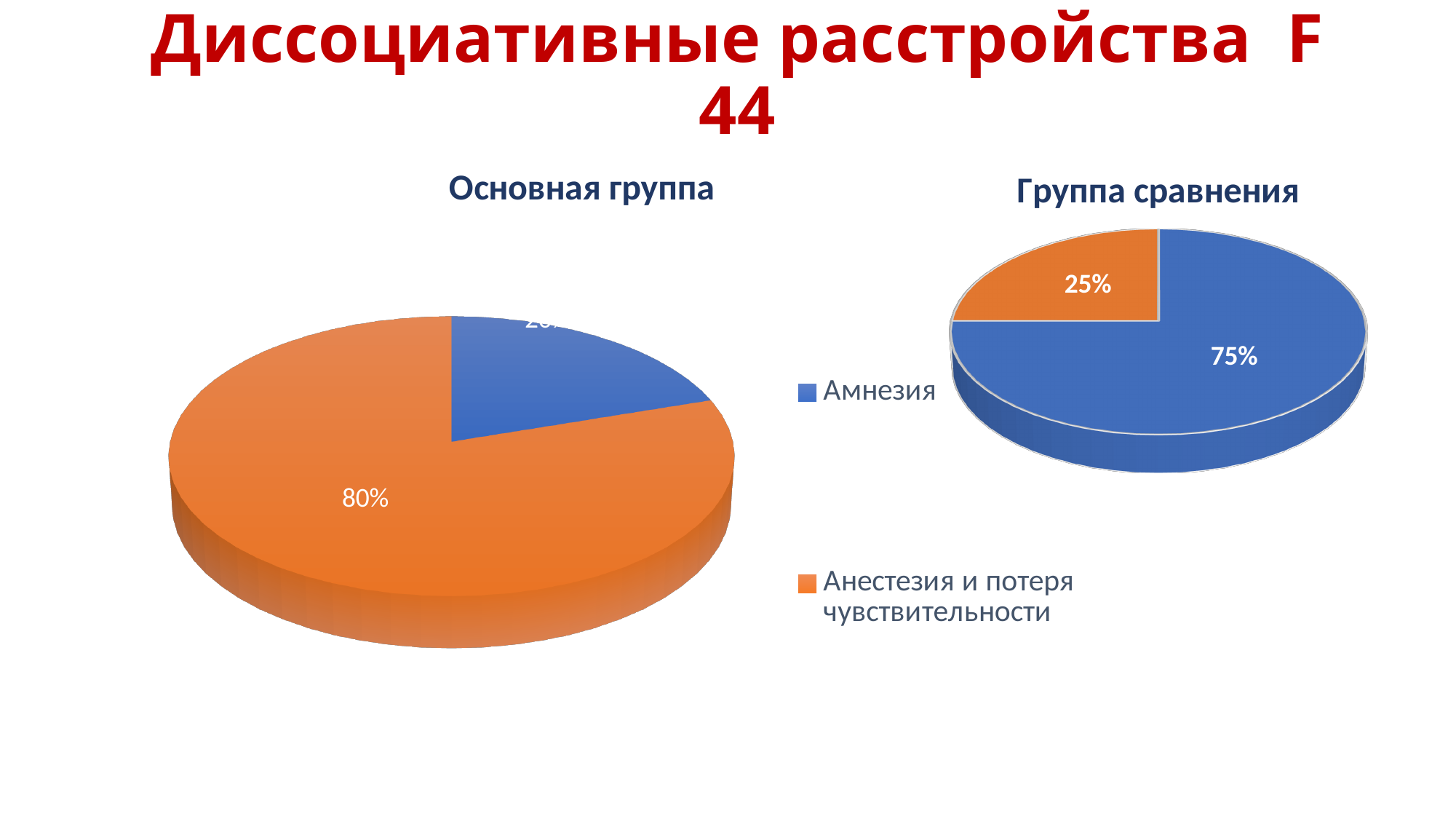
What kind of chart is "Группа сравнения"? pie chart In the "Группа сравнения" chart, which category has the smallest slice? Анестезия и потеря чувствительности Which colour represents "Амнезия" in the charts? blue In the "Группа сравнения" chart, what share does "Амнезия" have? 75% What kind of chart is "Основная группа"? pie chart In the "Группа сравнения" chart, what is the difference between the "Амнезия" and "Анестезия и потеря чувствительности" shares? 50% How many categories does the legend list? 2 In the "Основная группа" chart, what share does "Анестезия и потеря чувствительности" have? 80% In the "Основная группа" chart, which is larger: the "Амнезия" slice or the "Анестезия и потеря чувствительности" slice? Анестезия и потеря чувствительности In the "Группа сравнения" chart, what share does "Анестезия и потеря чувствительности" have? 25% In the "Группа сравнения" chart, which category has the largest slice? Амнезия In the "Основная группа" chart, which category has the largest slice? Анестезия и потеря чувствительности